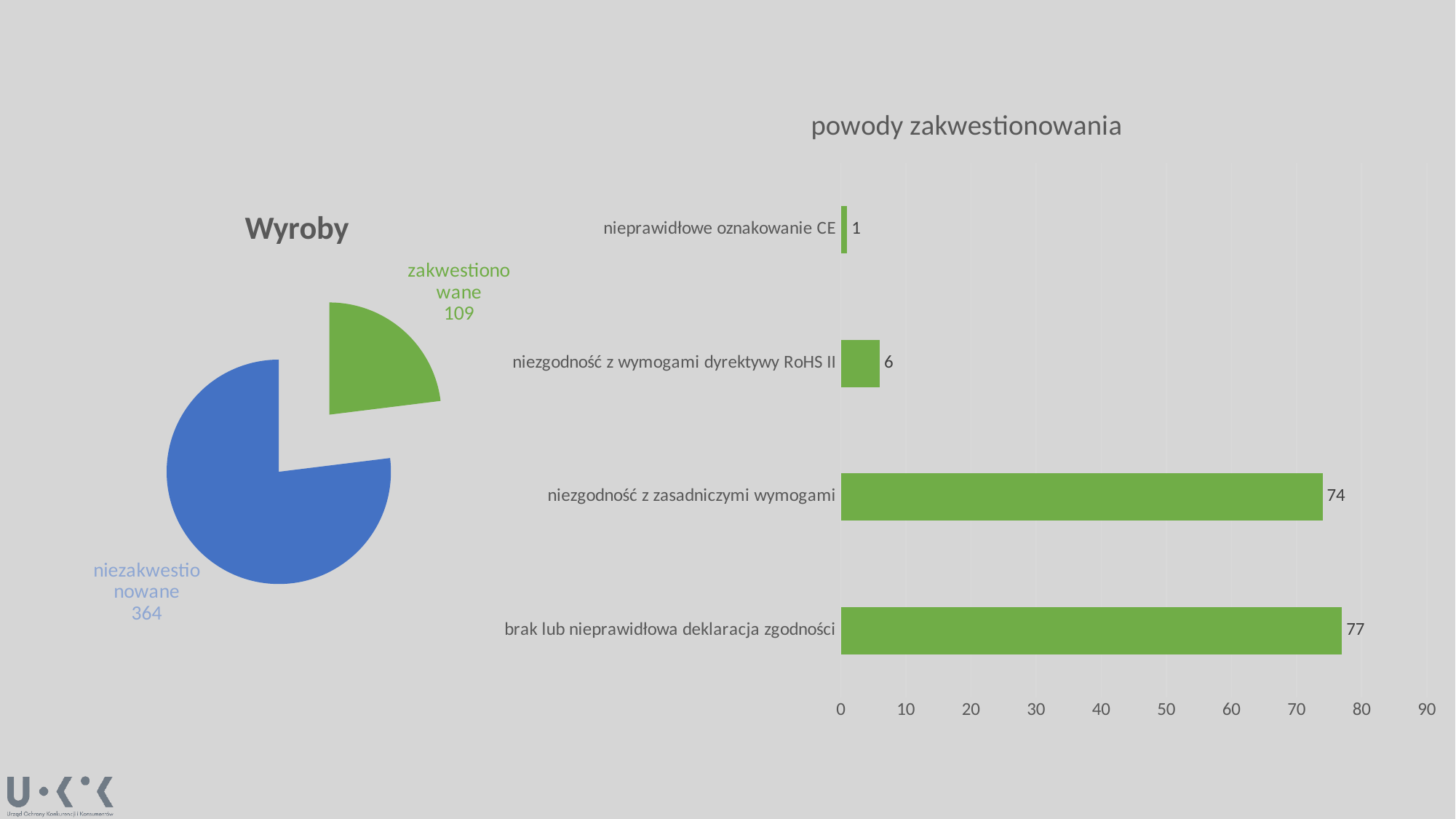
In the 'Wyroby' pie chart, what is the value for 'zakwestionowane'? 109 What kind of chart is the 'powody zakwestionowania' chart? bar chart In the 'powody zakwestionowania' chart, which category has the highest value? brak lub nieprawidłowa deklaracja zgodności In the 'Wyroby' pie chart, what share of the total does 'zakwestionowane' represent? 23% In the 'powody zakwestionowania' chart, what is the value for 'brak lub nieprawidłowa deklaracja zgodności'? 77 How many categories are shown in the 'powody zakwestionowania' chart? 4 In the 'powody zakwestionowania' chart, what is the value for 'niezgodność z wymogami dyrektywy RoHS II'? 6 What kind of chart is the 'Wyroby' chart? pie chart In the 'Wyroby' pie chart, what is the total of the two slices? 473 In the 'Wyroby' pie chart, what is the value for 'niezakwestionowane'? 364 In the 'powody zakwestionowania' chart, which category has the lowest value? nieprawidłowe oznakowanie CE In the 'powody zakwestionowania' chart, what is the difference between 'brak lub nieprawidłowa deklaracja zgodności' and 'niezgodność z zasadniczymi wymogami'? 3